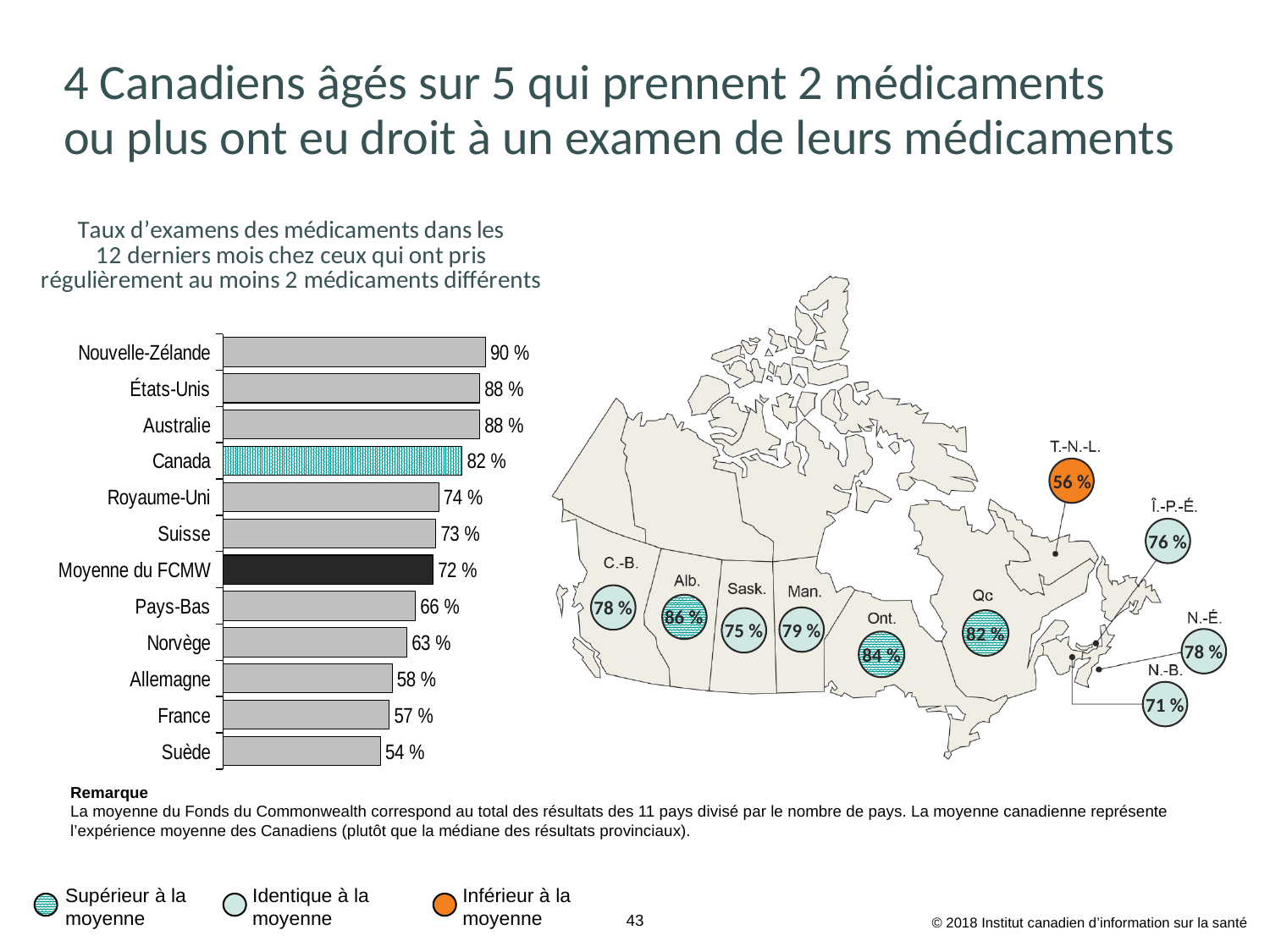
In the bar chart, which country has the lowest value? Suède On the map of Canada, which province has the lowest value? T.-N.-L. On the map of Canada, what is the value shown for Alb.? 86 % In the bar chart, what is the value for Canada? 82 % In the bar chart, what is the value for Moyenne du FCMW? 72 % In the bar chart, what is the value for Norvège? 63 % In the bar chart, which is larger, the value for Royaume-Uni or the value for Pays-Bas? Royaume-Uni In the bar chart, what is the difference between the values for Canada and Moyenne du FCMW? 10 % How many categories are shown in the bar chart? 12 In the bar chart, which bar is drawn in black? Moyenne du FCMW What kind of chart is shown on the left of the slide? Bar chart In the bar chart, which country has the highest value? Nouvelle-Zélande